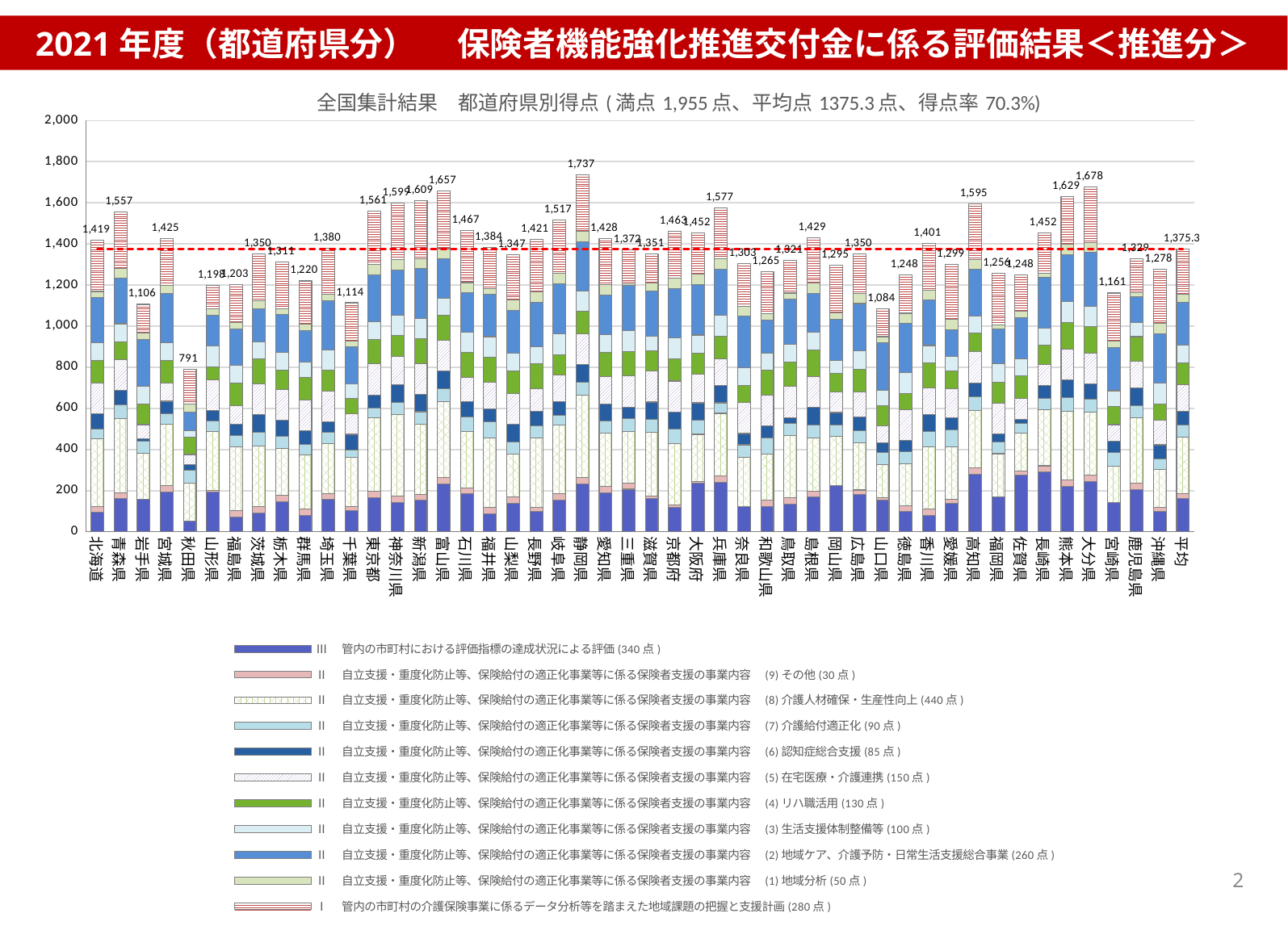
What is the maximum possible score (満点) stated in the chart title? 1,955点 What kind of chart is shown on the slide? Stacked bar chart Which prefecture has the highest total score? 静岡県 Which has a higher total score, 大分県 or 熊本県? 大分県 What is the total score shown for 秋田県? 791 What is the total score shown for 静岡県? 1,737 How many series does the legend list? 11 What is the value shown for 平均 (the average bar at the far right)? 1,375.3 What is the difference between the total scores of 北海道 and 青森県? 138 Is the total score for 山口県 greater or less than 1,200? less Which prefecture has the lowest total score? 秋田県 What is the difference between the total scores of 静岡県 and 秋田県? 946